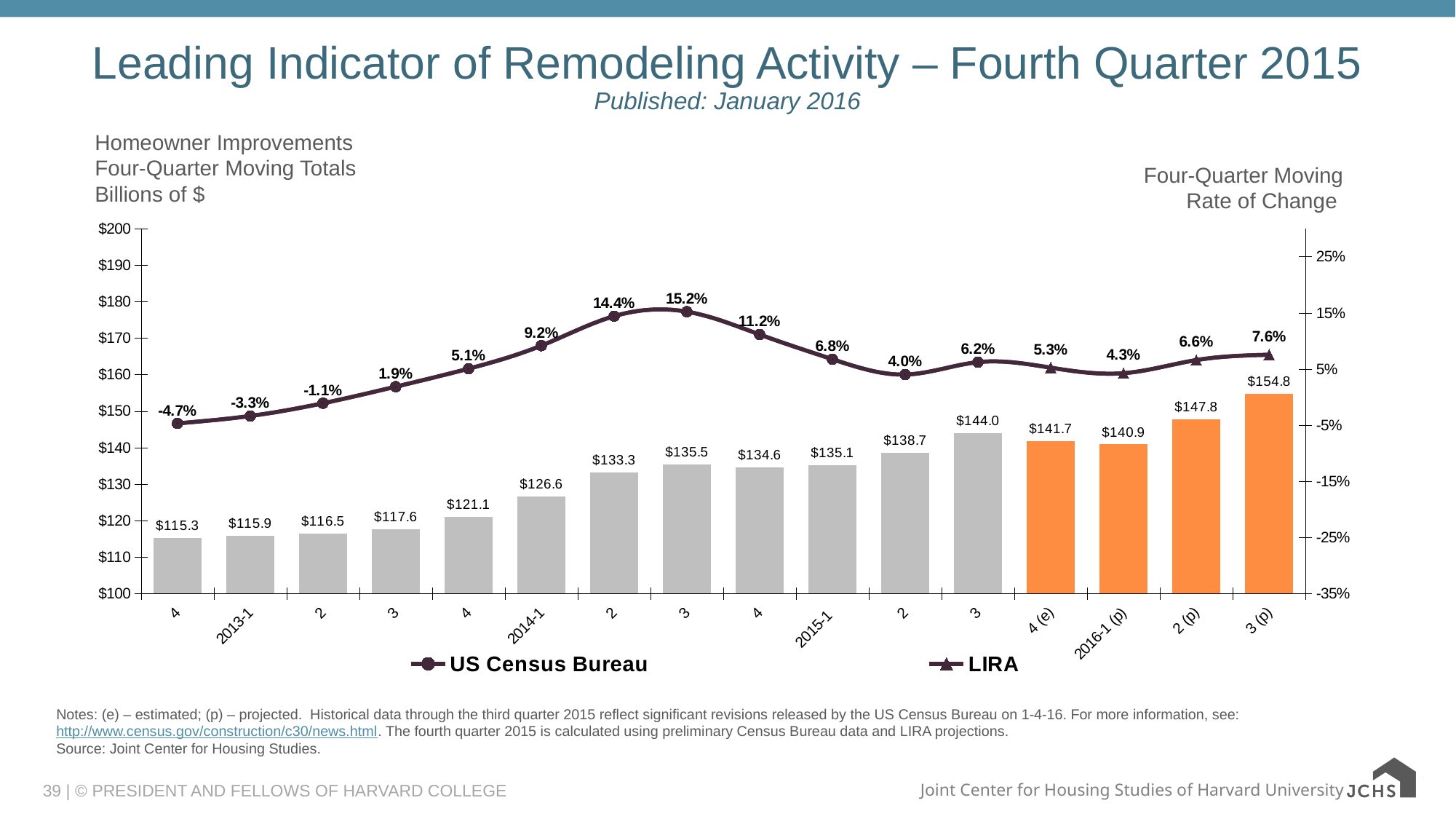
Which quarter has the lowest four-quarter moving total? 4 (2012), $115.3 What is the four-quarter moving total for 2015-1? $135.1 What is the four-quarter moving rate of change shown for the third quarter of 2014? 15.2% Which quarter has the highest four-quarter moving total? 3 (p) (2016), $154.8 How many series does the legend list? 2 What are the two series named in the legend? US Census Bureau and LIRA What is the difference between the four-quarter moving totals for 3 (p) and 2 (p) of 2016? $7.0 Do the four-quarter moving totals generally rise or fall from 2012 quarter 4 to 2016 quarter 3 (p)? Rise Which is larger, the four-quarter moving total for 2015 quarter 3 or for 2015 quarter 4 (e)? 2015 quarter 3 ($144.0) What kind of chart is this? Combination bar and line chart What is the lowest four-quarter moving rate of change shown on the line? -4.7% How many bars (quarters) are plotted in the chart? 16